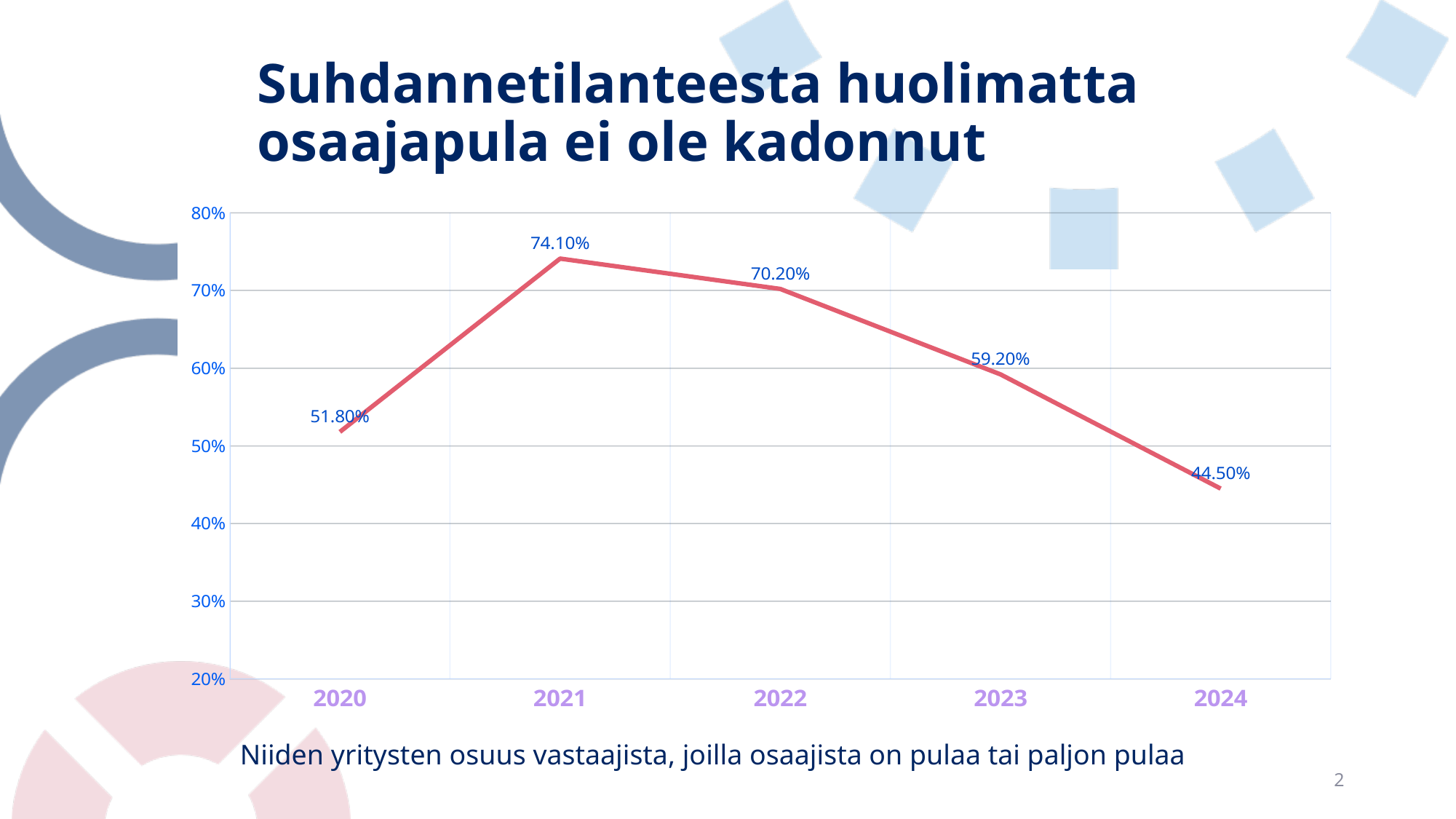
What is the value for 2021? 74.10% What is the value for 2020? 51.80% Is the value for 2022 greater or less than 60%? greater Which year has the highest value? 2021 What is the difference between the values for 2022 and 2023? 11.00% What kind of chart is shown on the slide? line chart Which is larger, the value for 2020 or the value for 2023? 2023 How many years are plotted on the chart? 5 What is the value for 2024? 44.50% Do the values rise or fall from 2021 to 2024? fall What is the difference between the values for 2021 and 2024? 29.60% Which year has the lowest value? 2024